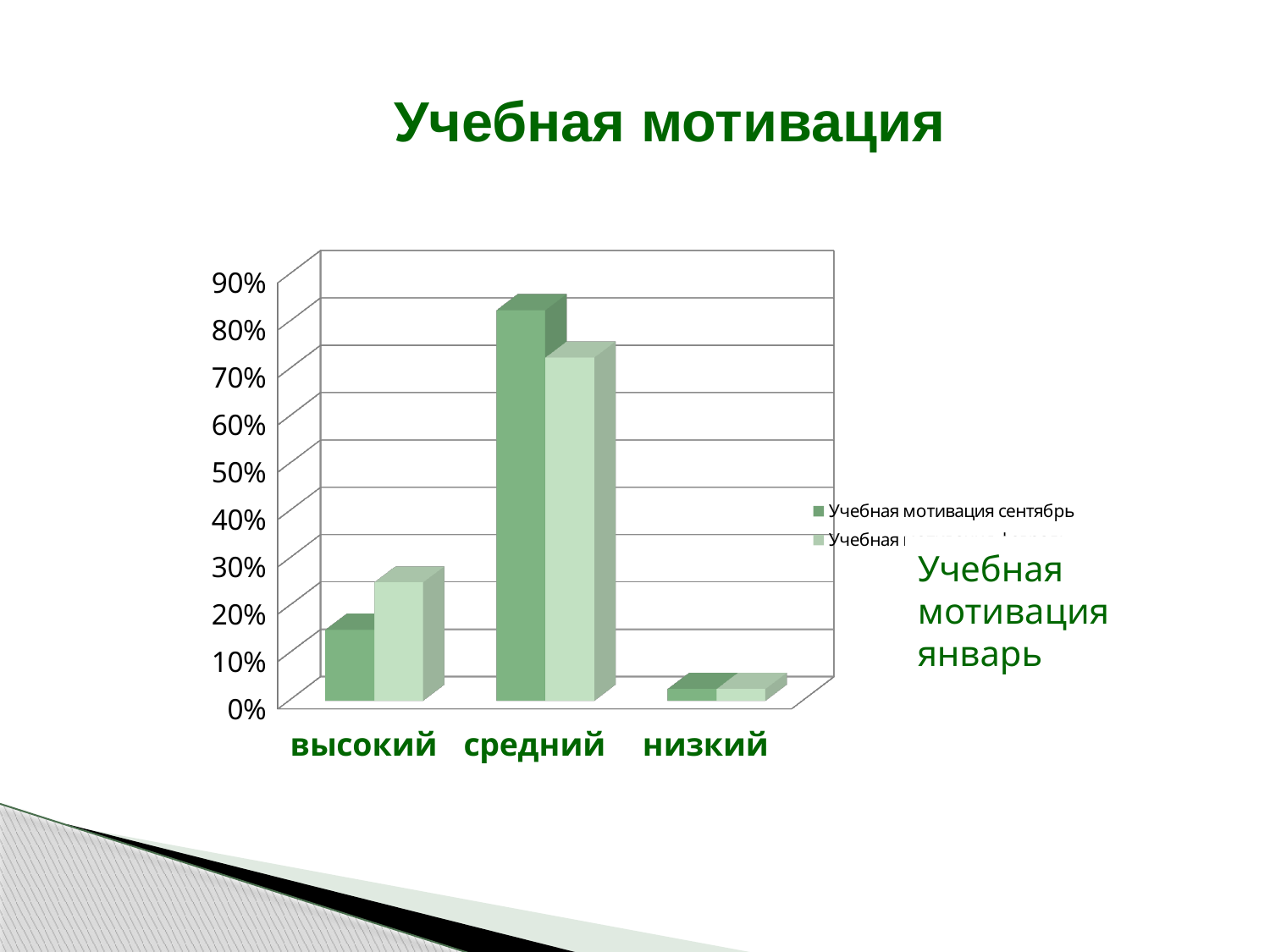
What kind of chart is shown on the slide? bar chart Is the value for средний in the series Учебная мотивация январь greater or less than 60%? greater How many series does the chart's legend list? 2 Is the value for средний in the series Учебная мотивация сентябрь greater or less than 70%? greater For the category средний, which series has the larger value: Учебная мотивация сентябрь or Учебная мотивация январь? Учебная мотивация сентябрь Is the value for низкий in the series Учебная мотивация сентябрь greater or less than 10%? less What is the title of the slide containing the chart? Учебная мотивация Which category has the lowest value for the series Учебная мотивация январь? низкий Which category has the highest value for the series Учебная мотивация сентябрь? средний How many categories are shown on the x axis of the chart? 3 For the category высокий, which series has the larger value: Учебная мотивация сентябрь or Учебная мотивация январь? Учебная мотивация январь